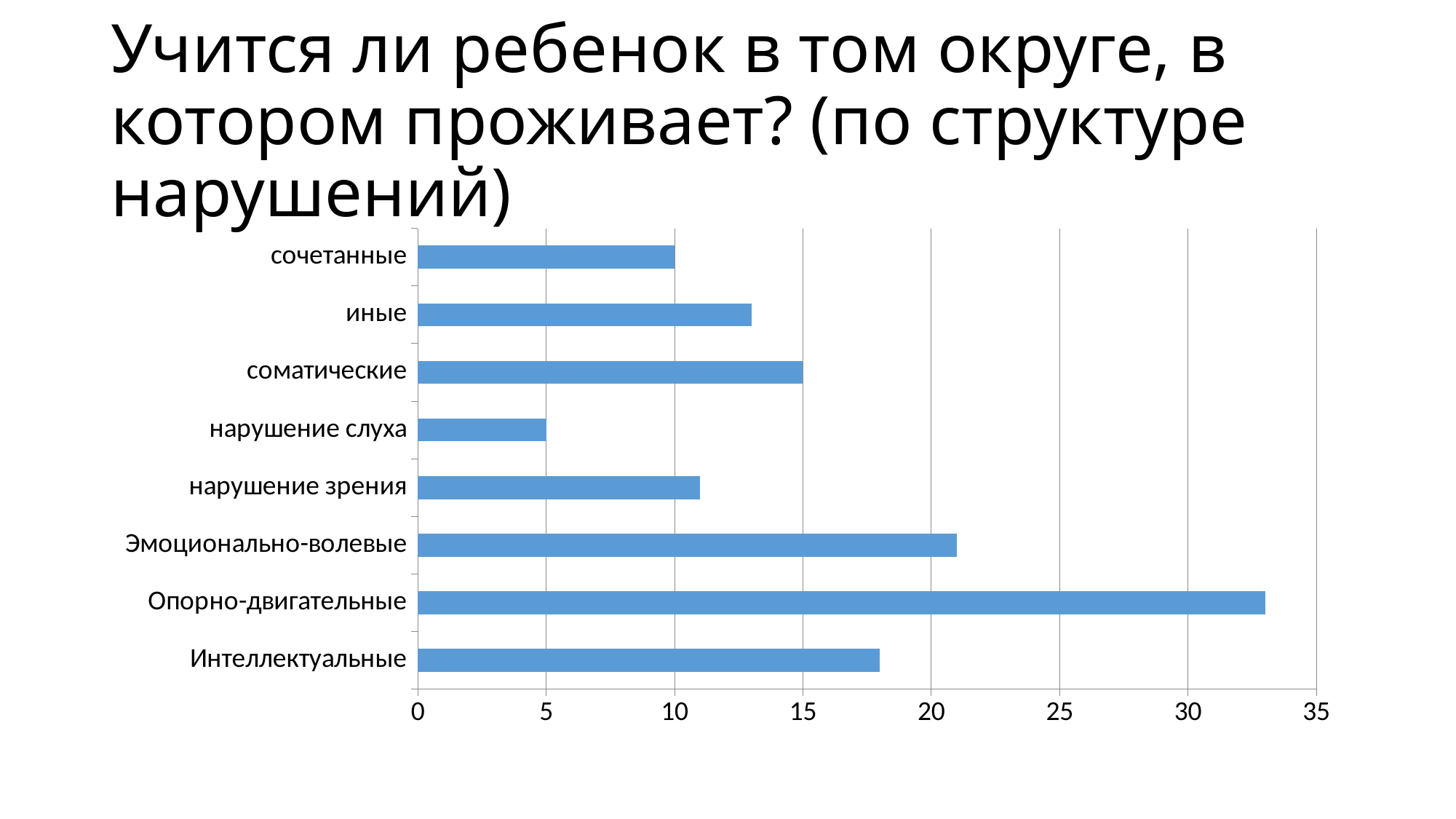
Which is larger, the value for Эмоционально-волевые or the value for Интеллектуальные? Эмоционально-волевые What is the maximum value shown on the horizontal axis? 35 What is the value for сочетанные? 10 Which category has the highest value? Опорно-двигательные What is the value for нарушение слуха? 5 How many categories are plotted in the chart? 8 Which category has the lowest value? нарушение слуха What is the value for соматические? 15 Is the value for Опорно-двигательные greater or less than 30? greater Is the value for Интеллектуальные greater or less than 20? less Is the value for Эмоционально-волевые greater or less than 20? greater What type of chart is shown on the slide? bar chart